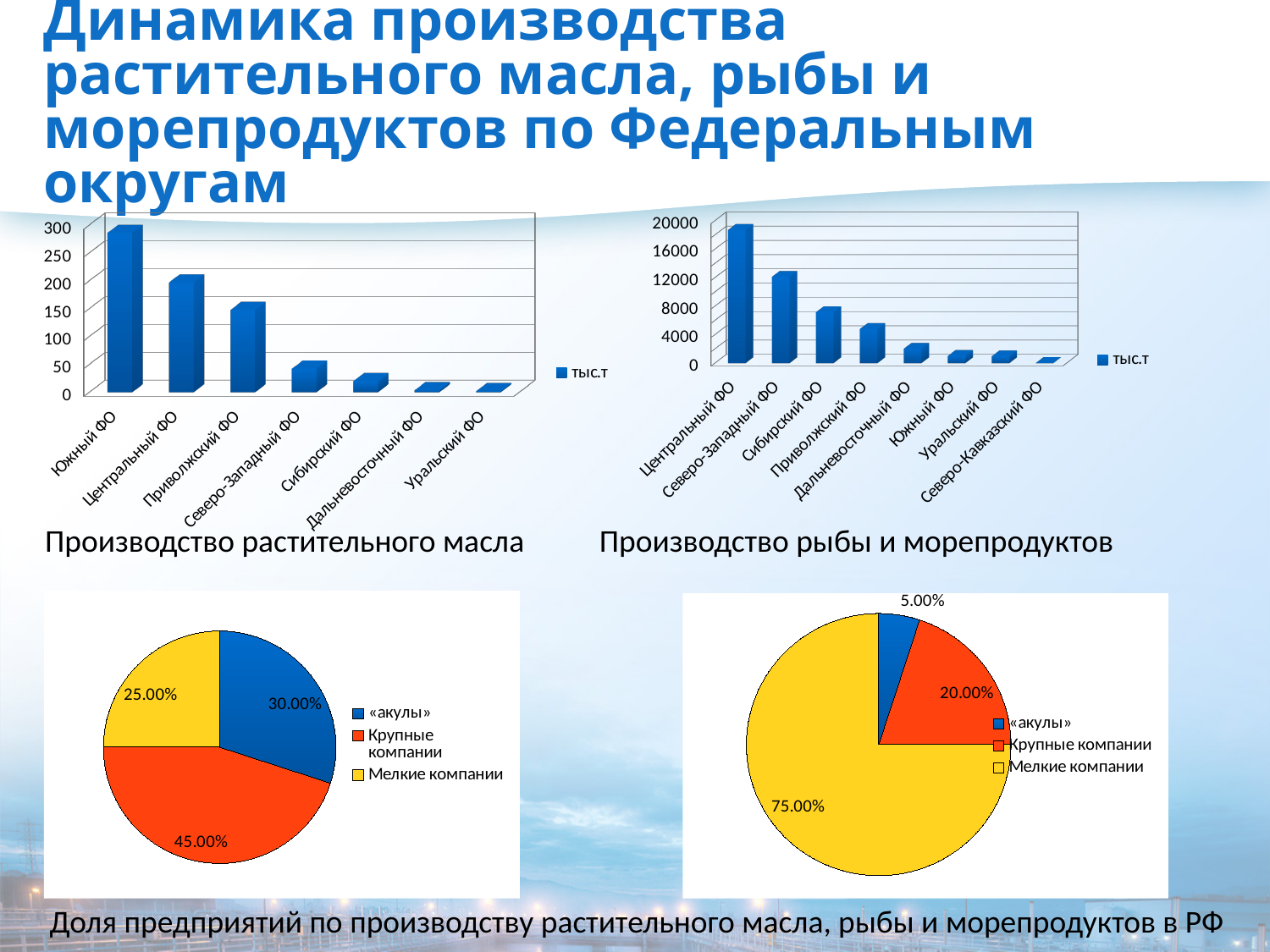
In the 'Производство рыбы и морепродуктов' bar chart, is the value for Северо-Западный ФО greater or less than 8000? greater In the bottom-left pie chart, what share do Крупные компании have? 45.00% In the 'Производство растительного масла' bar chart, is the value for Северо-Западный ФО greater or less than 100? less How many federal districts are shown in the 'Производство растительного масла' bar chart? 7 In the 'Производство рыбы и морепродуктов' bar chart, which federal district has the lowest value? Северо-Кавказский ФО In the 'Производство растительного масла' bar chart, do the values rise or fall from left to right along the x axis? fall In the 'Производство растительного масла' bar chart, is the value for Центральный ФО greater or less than 150? greater In the 'Производство растительного масла' bar chart, which federal district has the highest value? Южный ФО In the 'Производство рыбы и морепродуктов' bar chart, which federal district has the highest value? Центральный ФО How many federal districts are shown in the 'Производство рыбы и морепродуктов' bar chart? 8 In the bottom-right pie chart, what share do Мелкие компании have? 75.00% In the bottom-right pie chart, what is the difference between the shares of Крупные компании and «акулы»? 15.00%